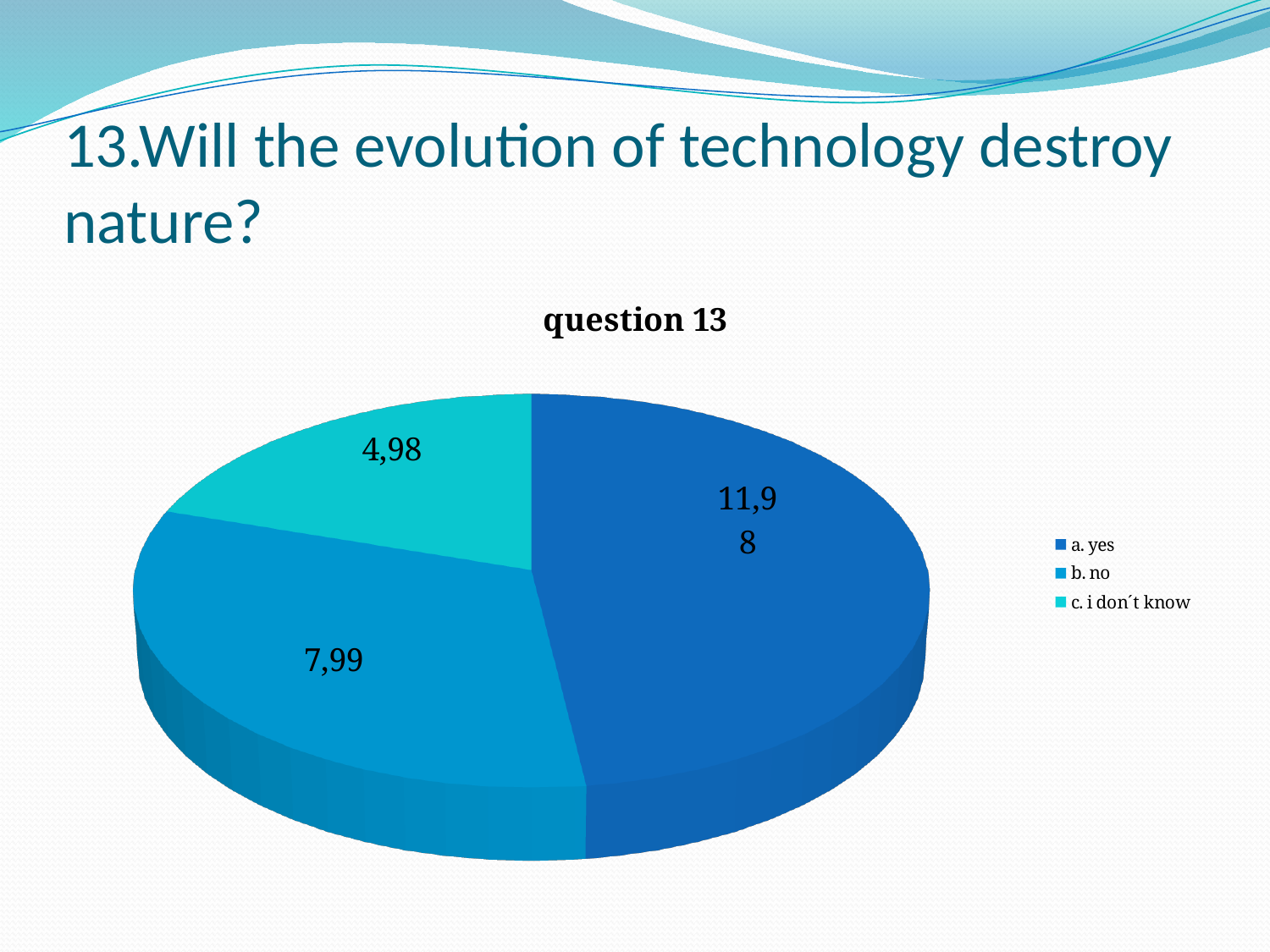
What is the title of the pie chart? question 13 Which answer option has the smallest slice in the pie chart? c. i don't know How many slices does the pie chart have? 3 Which is larger in the pie chart, the value for "b. no" or the value for "c. i don't know"? b. no What kind of chart is shown on the slide? pie chart What is the difference between the values for "b. no" and "c. i don't know" in the pie chart? 3,01 What is the value for "b. no" in the question 13 pie chart? 7,99 How many entries does the legend of the pie chart list? 3 What is the difference between the values for "a. yes" and "b. no" in the pie chart? 3,99 What is the value for "a. yes" in the question 13 pie chart? 11,98 Which answer option has the largest slice in the pie chart? a. yes What is the value for "c. i don't know" in the question 13 pie chart? 4,98